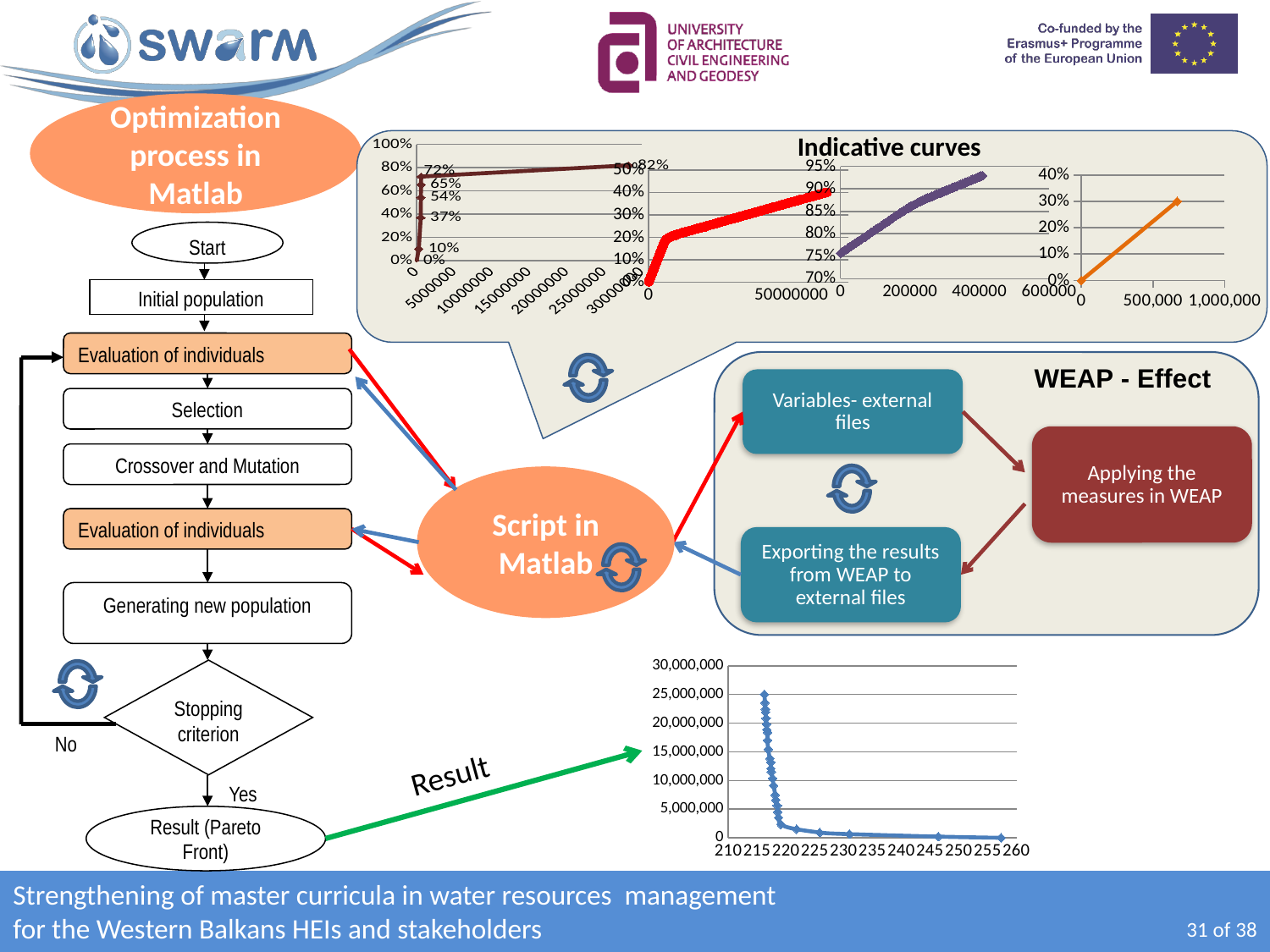
In the leftmost chart under 'Indicative curves', what is the lowest data label shown? 0% In the chart at the bottom right of the slide, is the highest plotted value greater or less than 20,000,000? greater In the rightmost (orange) chart under 'Indicative curves', do the values rise or fall along the x axis? rise In the chart at the bottom right of the slide, do the values rise or fall as the x axis goes from 210 to 260? fall In the leftmost chart under 'Indicative curves', what is the highest data label shown? 82% In the third (purple) chart under 'Indicative curves', what is the maximum value shown on the vertical axis? 95% How many small charts are shown inside the 'Indicative curves' box? 4 In the leftmost chart under 'Indicative curves', what is the difference between the 72% and 54% labelled points? 18% In the chart at the bottom right of the slide, what is the maximum value shown on the vertical axis? 30,000,000 In the rightmost (orange) chart under 'Indicative curves', is the highest plotted value greater or less than 20%? greater In the leftmost chart under 'Indicative curves', which labelled value is larger, 65% or 37%? 65%